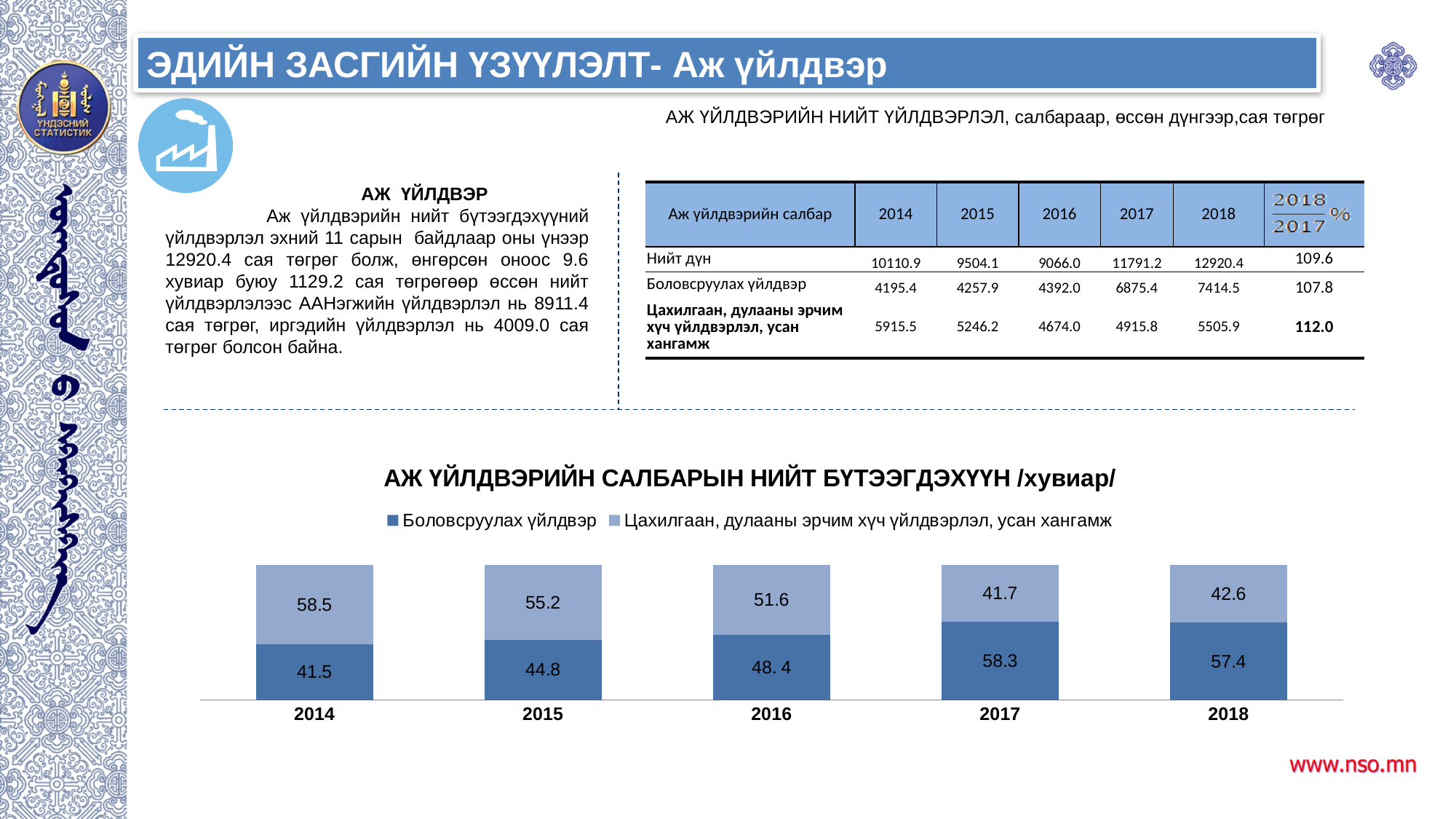
In which year is the value for Боловсруулах үйлдвэр the highest? 2017 What kind of chart is shown on the slide? Stacked bar chart How many series does the chart legend list? 2 In 2015, which series has the larger value: Боловсруулах үйлдвэр or Цахилгаан, дулааны эрчим хүч үйлдвэрлэл, усан хангамж? Цахилгаан, дулааны эрчим хүч үйлдвэрлэл, усан хангамж What is the value for Цахилгаан, дулааны эрчим хүч үйлдвэрлэл, усан хангамж in 2018? 42.6 What is the value for Боловсруулах үйлдвэр in 2017? 58.3 How many years are shown on the x axis of the chart? 5 Does the value for Боловсруулах үйлдвэр rise or fall from 2014 to 2017? Rise What is the value for Боловсруулах үйлдвэр in 2014? 41.5 What is the difference between Боловсруулах үйлдвэр and Цахилгаан, дулааны эрчим хүч үйлдвэрлэл, усан хангамж in 2017? 16.6 In which year is the value for Цахилгаан, дулааны эрчим хүч үйлдвэрлэл, усан хангамж the lowest? 2017 What is the total of the stacked bar for 2014? 100